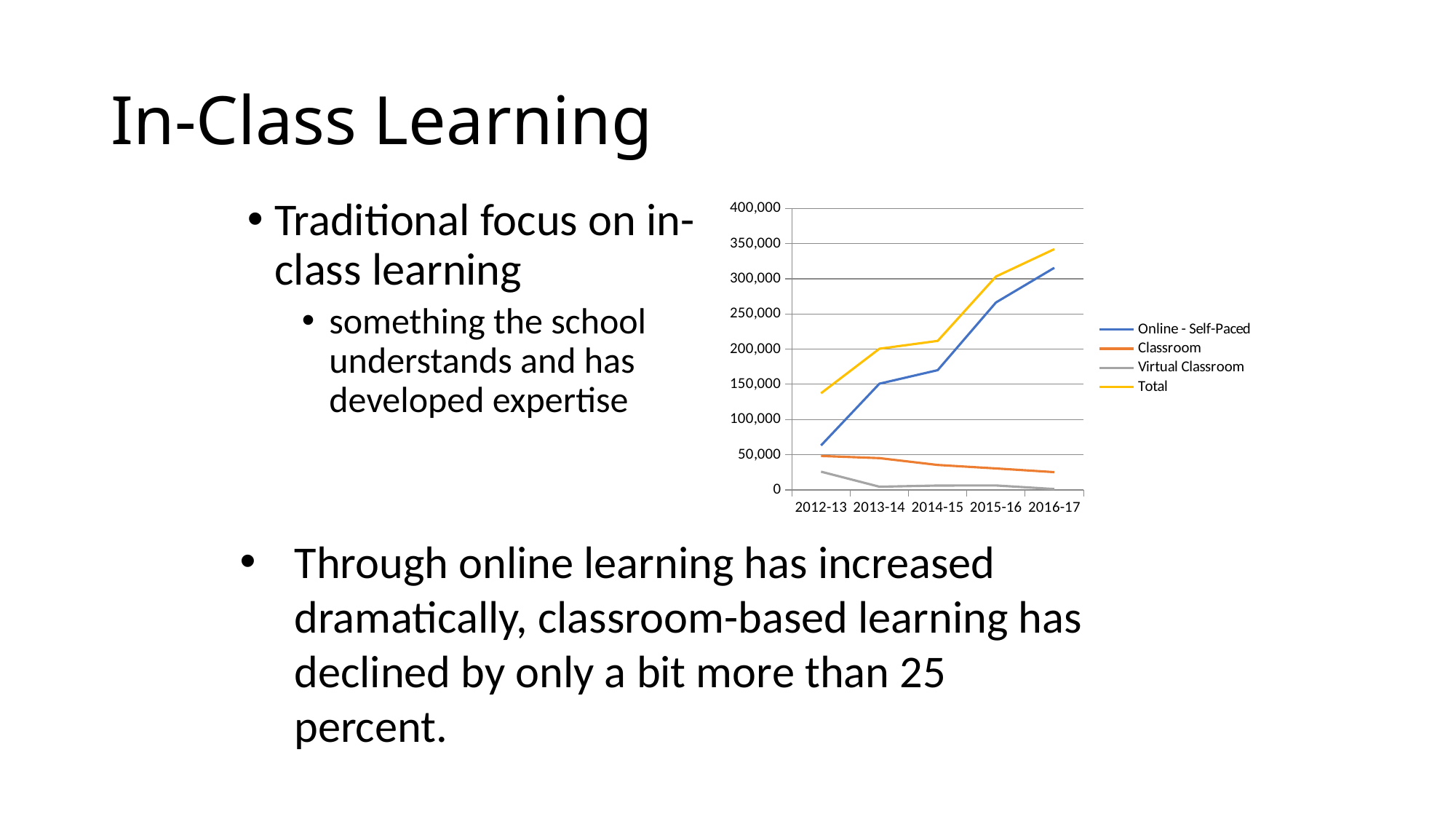
Is the Total value for 2016-17 greater or less than 300,000? greater Is the Classroom value for 2016-17 greater or less than 50,000? less What kind of chart is shown on the slide? line chart In which year is the Total line at its highest? 2016-17 Which is larger in 2014-15, Online - Self-Paced or Classroom? Online - Self-Paced How many academic years are shown on the x axis of the chart? 5 Which series has the highest value in 2016-17? Total Does the Online - Self-Paced line rise or fall from 2012-13 to 2016-17? rise Which series has the lowest value in 2016-17? Virtual Classroom Does the Classroom line rise or fall from 2012-13 to 2016-17? fall How many series does the chart's legend list? 4 Is the Total value for 2012-13 greater or less than 150,000? less